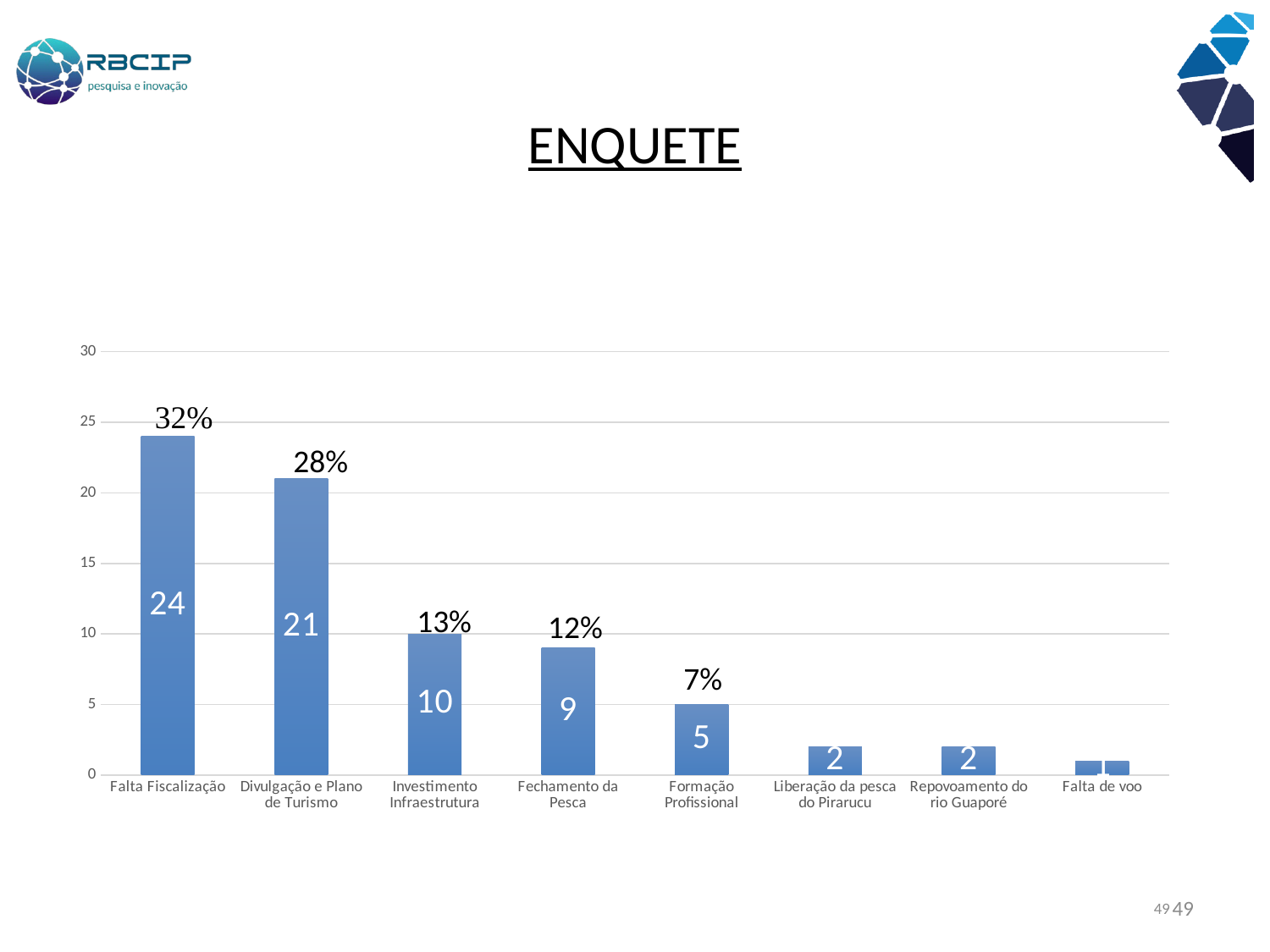
What is the value for Formação Profissional? 5 Which is larger, the value for Fechamento da Pesca or the value for Formação Profissional? Fechamento da Pesca What is the value for Falta Fiscalização? 24 What is the value for Investimento Infraestrutura? 10 What percentage label is shown above the Divulgação e Plano de Turismo bar? 28% Is the value for Falta de voo greater or less than 5? less Which category has the lowest value? Falta de voo What is the difference between the values for Falta Fiscalização and Divulgação e Plano de Turismo? 3 Which category has the highest value? Falta Fiscalização What is the title of the slide? ENQUETE How many categories are shown on the x axis? 8 What kind of chart is shown on the slide? bar chart